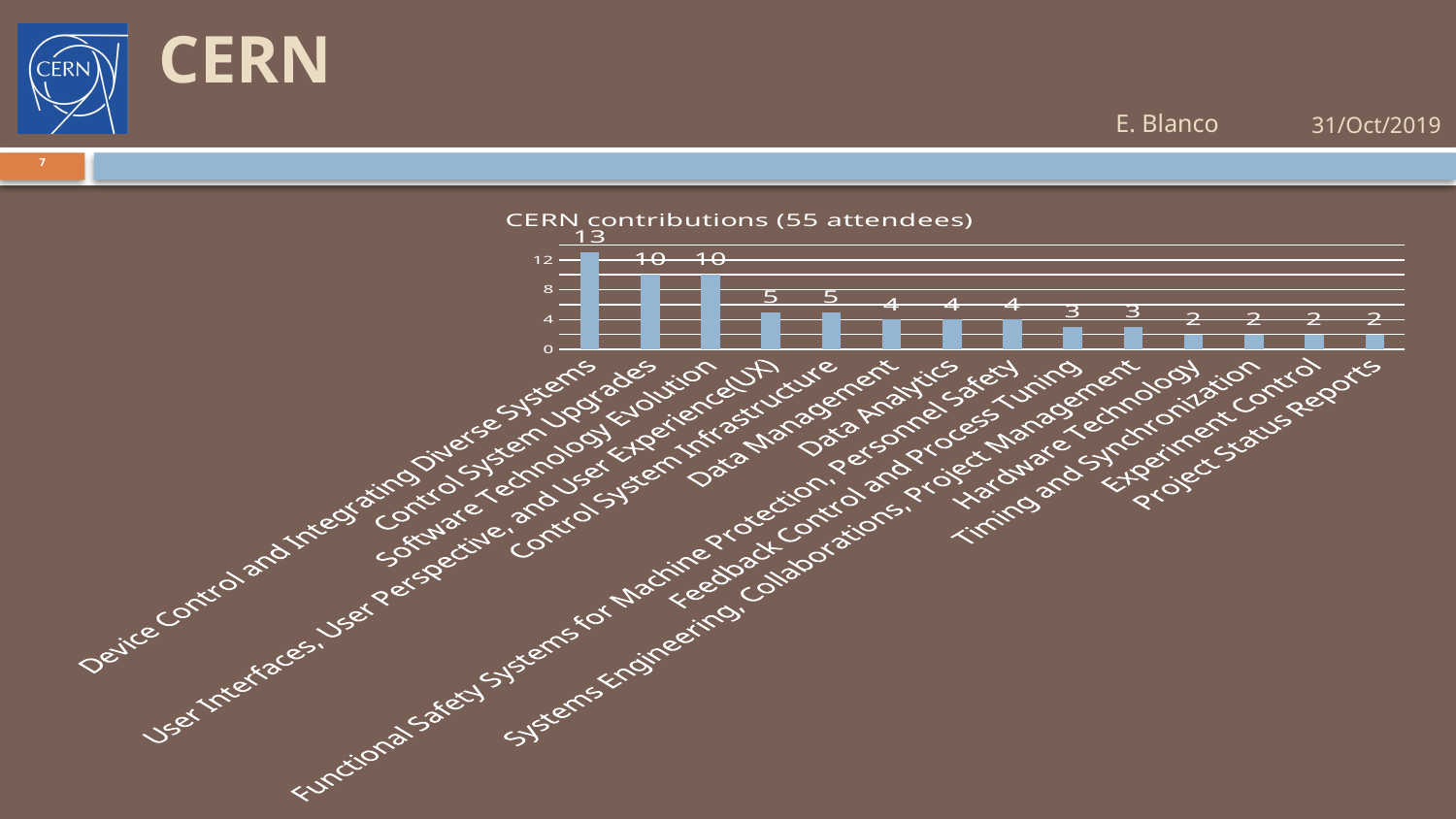
How many categories are shown in the chart? 14 What kind of chart is shown on the slide? bar chart What is the value for Control System Upgrades? 10 What is the value for Device Control and Integrating Diverse Systems? 13 Which category has the highest value? Device Control and Integrating Diverse Systems What is the value for Data Management? 4 Which is larger, the value for Control System Infrastructure or the value for Feedback Control and Process Tuning? Control System Infrastructure What is the title of the chart? CERN contributions (55 attendees) Is the value for Device Control and Integrating Diverse Systems greater or less than 12? greater Do the values rise or fall from left to right along the x axis? fall What is the value for Hardware Technology? 2 What is the difference between the values for Device Control and Integrating Diverse Systems and Software Technology Evolution? 3